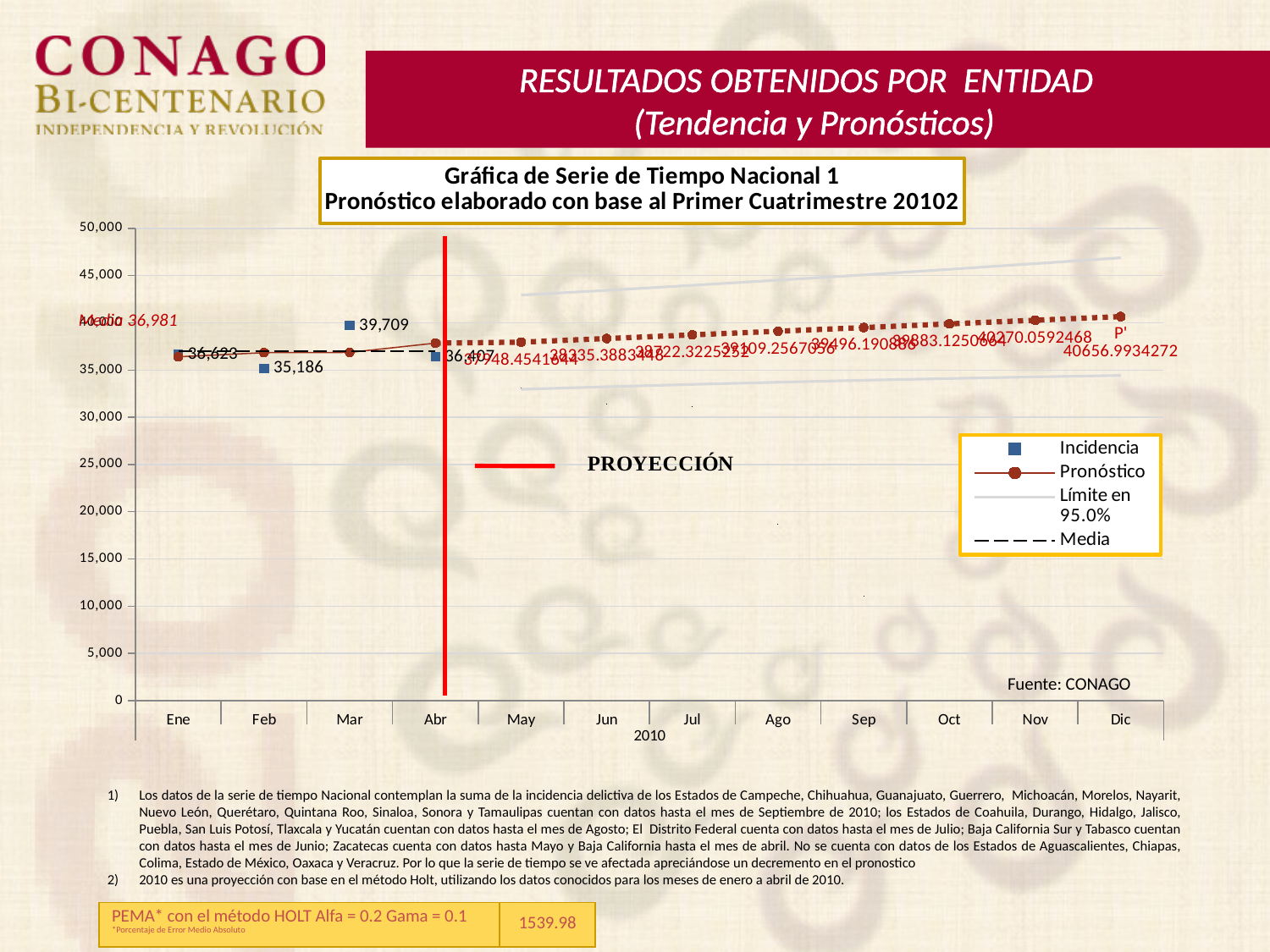
What is the Incidencia value for Feb? 35,186 What value is shown for the Media line? 36,981 What is the Incidencia value for Abr? 36,407 Which month has the highest Incidencia value? Mar Which month has the lowest Incidencia value? Feb What is the difference between the Incidencia values for Mar and Feb? 4,523 How many months are shown on the x axis? 12 What is the Incidencia value for Ene? 36,623 Does the Pronóstico series rise or fall from May to Dic? rises What is the Incidencia value for Mar? 39,709 Which is larger, the Incidencia value for Ene or for Abr? Ene How many series does the legend list? 4